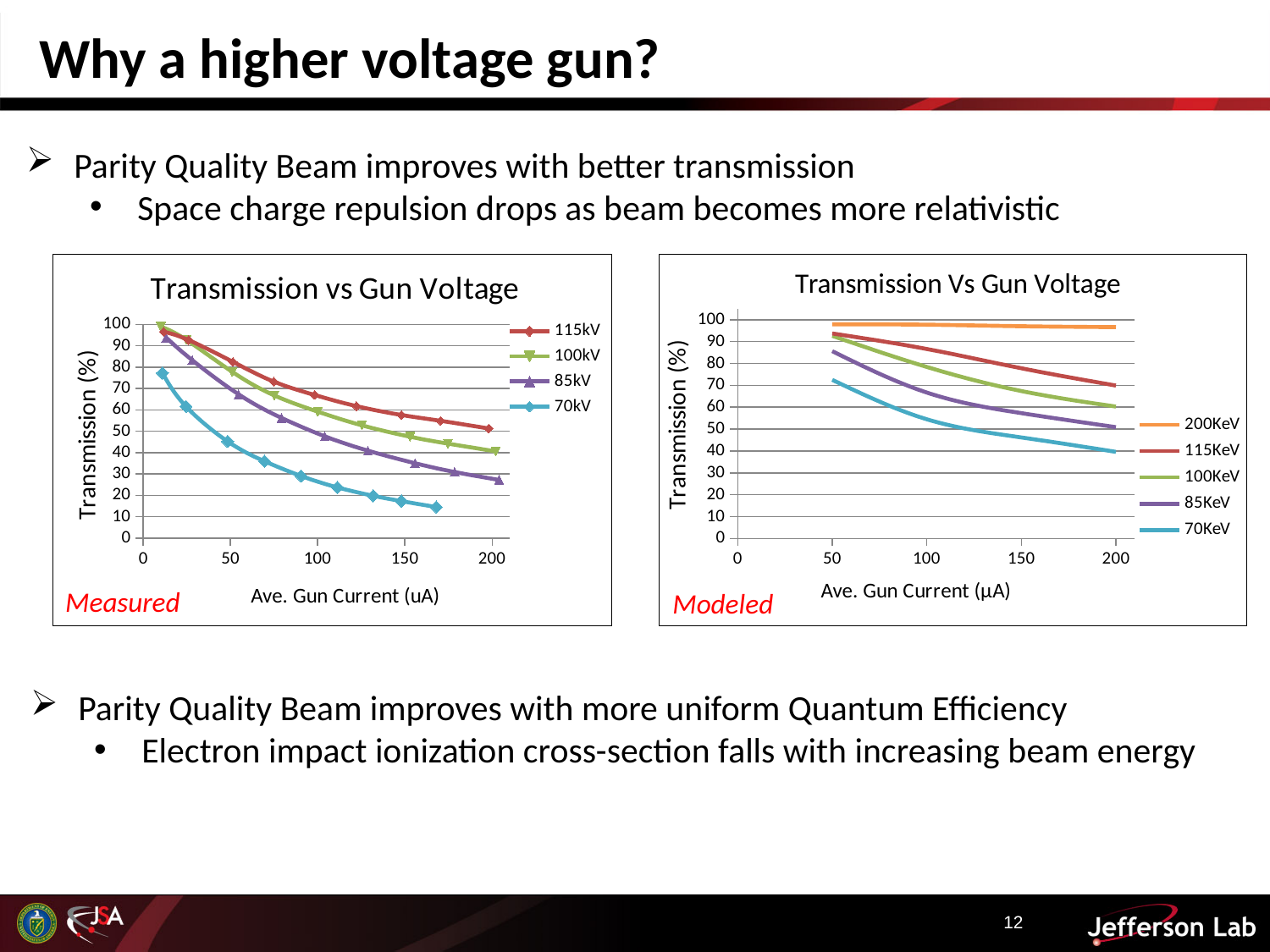
What kind of chart is the left chart titled "Transmission vs Gun Voltage" (Measured)? line chart How many series does the legend of the right chart (Modeled) list? 5 In the right chart (Modeled), which series has the highest transmission at 200 µA? 200KeV In the left chart (Measured), at 100 uA, which series has the higher transmission: 115kV or 70kV? 115kV In the right chart (Modeled), is the 85KeV transmission at 50 µA greater or less than 80? greater In the right chart (Modeled), is the 200KeV transmission at 200 µA greater or less than 90? greater How many series does the legend of the left chart (Measured) list? 4 In the left chart (Measured), does the 70kV transmission rise or fall as the average gun current increases? fall In the right chart (Modeled), does the 115KeV transmission rise or fall as the average gun current increases? fall What is the x-axis label of the right chart (Modeled)? Ave. Gun Current (µA) In the left chart (Measured), is the 85kV transmission at 200 uA greater or less than 30? less